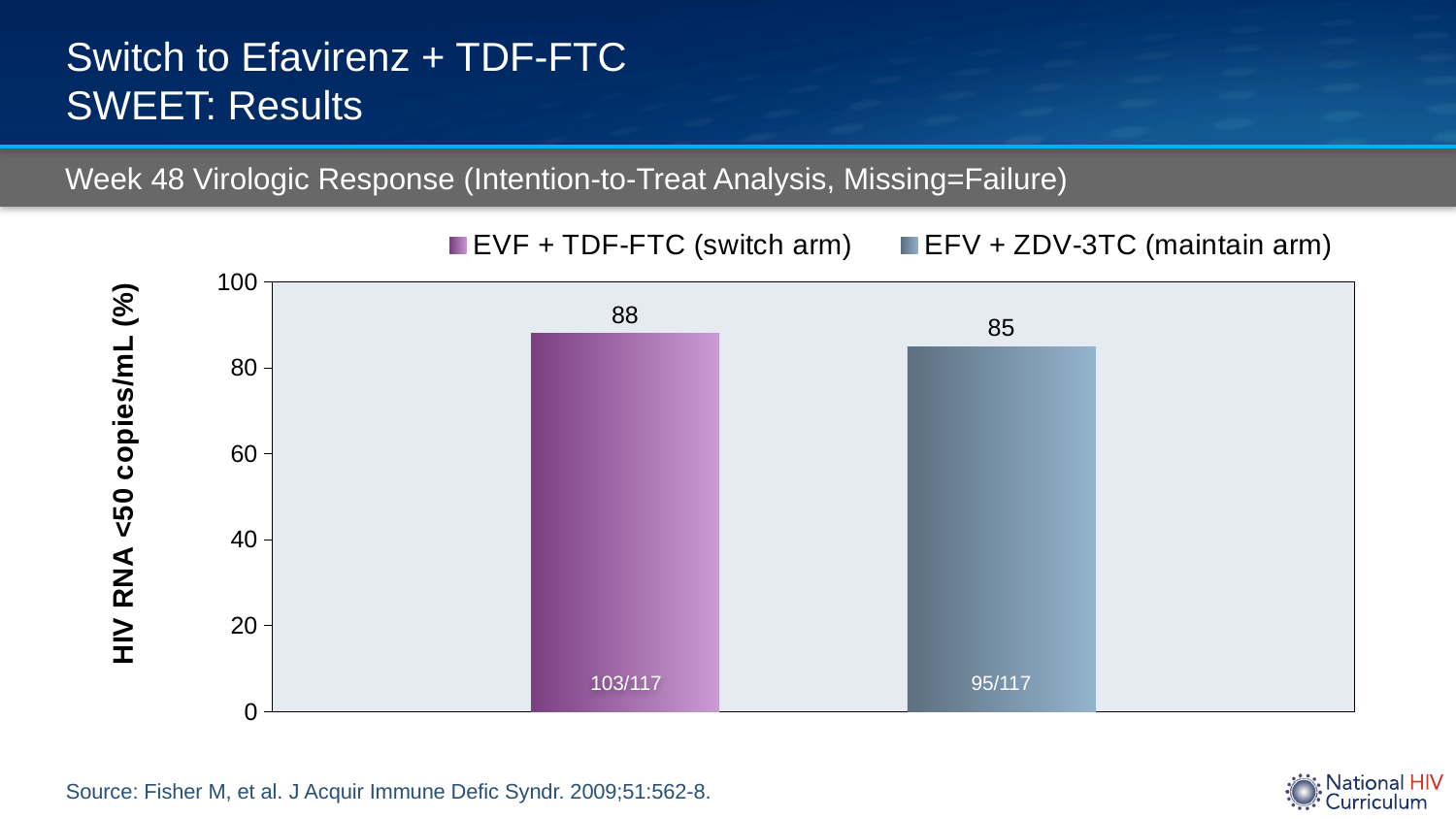
Is the value for the switch arm or the maintain arm larger? EVF + TDF-FTC (switch arm) What is the value for EFV + ZDV-3TC (maintain arm)? 85 What kind of chart is shown? bar chart Is the value for EFV + ZDV-3TC (maintain arm) greater or less than 80? greater How many series does the legend list? 2 Which arm has the higher percentage with HIV RNA <50 copies/mL? EVF + TDF-FTC (switch arm) What fraction is printed inside the bar for the maintain arm? 95/117 Which arm has the lower percentage with HIV RNA <50 copies/mL? EFV + ZDV-3TC (maintain arm) What is the value for EVF + TDF-FTC (switch arm)? 88 What is the difference between the switch arm and the maintain arm values? 3 What is the label of the y axis? HIV RNA <50 copies/mL (%) What fraction is printed inside the bar for the switch arm? 103/117